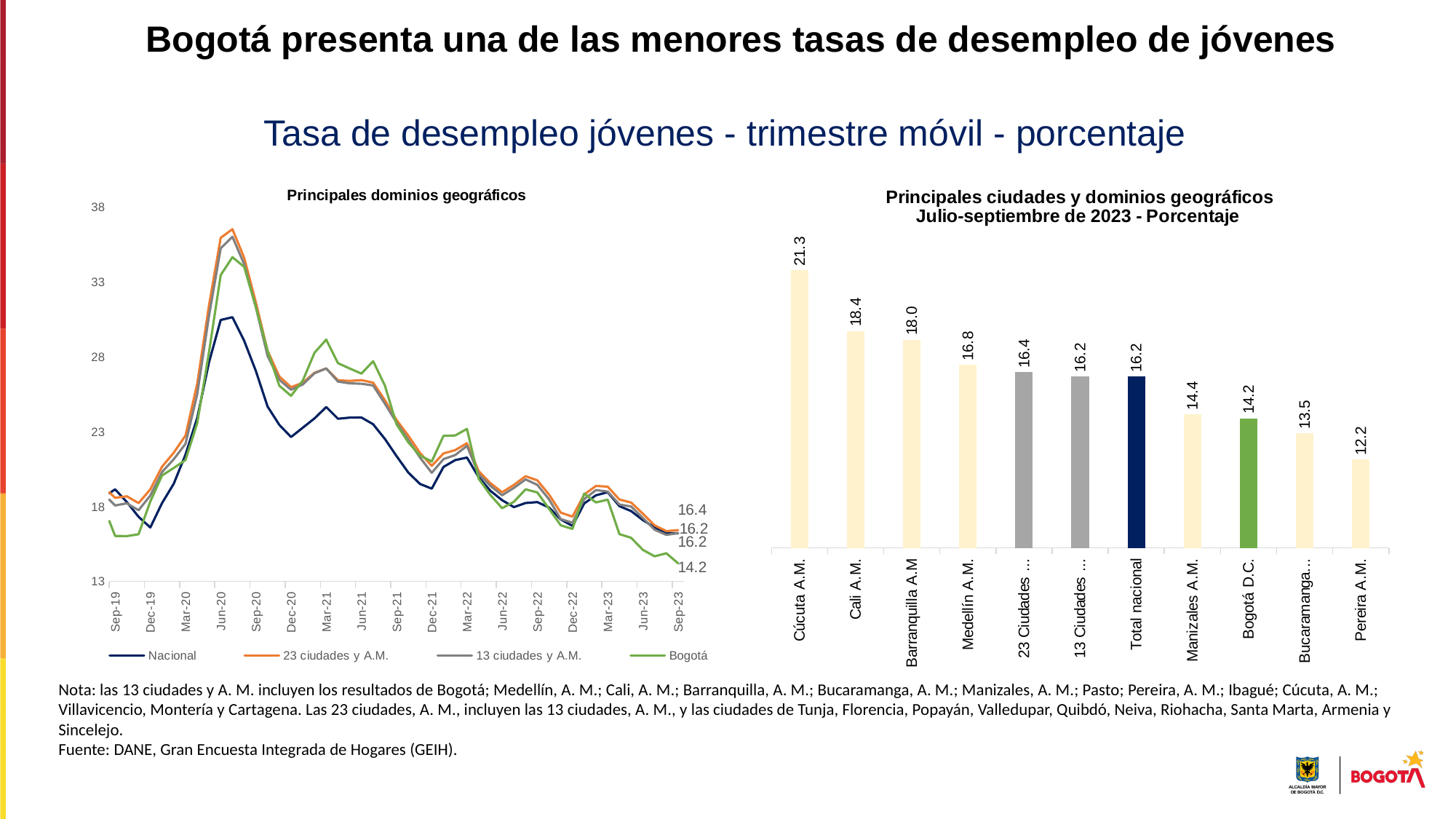
In the chart titled 'Principales ciudades y dominios geográficos', which category has the highest value? Cúcuta A.M. In the chart titled 'Principales ciudades y dominios geográficos', how many bars are shown? 11 In the chart titled 'Principales dominios geográficos', what is the value for Bogotá at Sep-23? 14.2 In the chart titled 'Principales ciudades y dominios geográficos', which category has the lowest value? Pereira A.M. In the chart titled 'Principales dominios geográficos', how many series does the legend list? 4 In the chart titled 'Principales ciudades y dominios geográficos', what is the value for Bogotá D.C.? 14.2 In the chart titled 'Principales ciudades y dominios geográficos', what is the difference between the values for Cúcuta A.M. and Bogotá D.C.? 7.1 In the chart titled 'Principales ciudades y dominios geográficos', which is larger, the value for Cali A.M. or the value for Medellín A.M.? Cali A.M. What kind of chart is the chart titled 'Principales dominios geográficos'? Line chart What kind of chart is the chart titled 'Principales ciudades y dominios geográficos'? Bar chart In the chart titled 'Principales ciudades y dominios geográficos', what is the value for Cúcuta A.M.? 21.3 In the chart titled 'Principales dominios geográficos', is the value for Nacional at Jun-20 greater or less than 28? greater